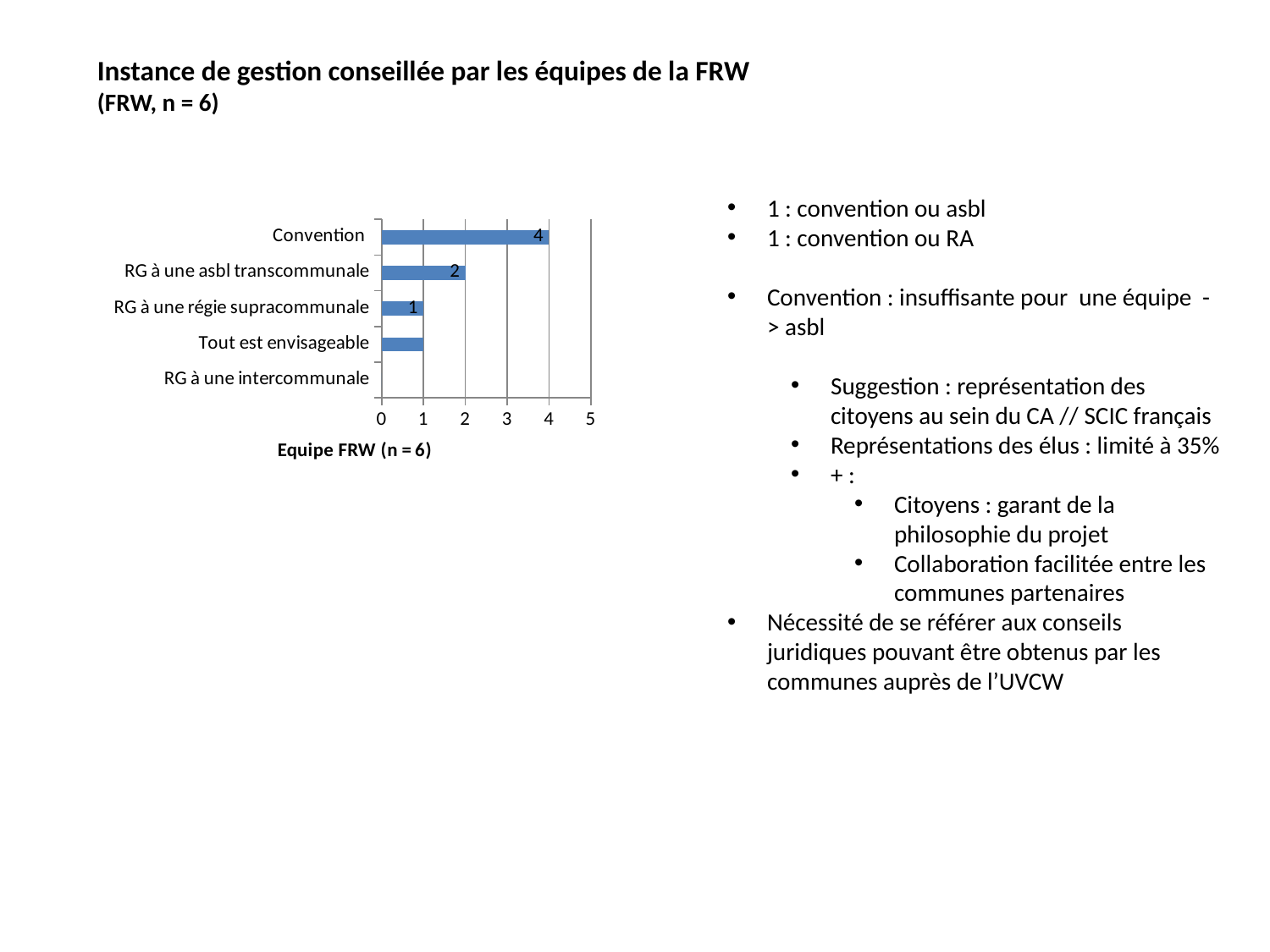
What kind of chart is shown on the slide? Bar chart What is the difference between the values for Convention and RG à une asbl transcommunale? 2 What is the value for Tout est envisageable? 1 What is the value for RG à une régie supracommunale? 1 How many categories are shown on the chart? 5 Which category has the highest value? Convention Which category has the lowest value? RG à une intercommunale What is the legend entry shown below the chart? Equipe FRW (n = 6) What is the value for RG à une asbl transcommunale? 2 Which is larger, the value for Convention or the value for RG à une régie supracommunale? Convention What is the value for Convention? 4 Is the value for Convention greater or less than 3? greater